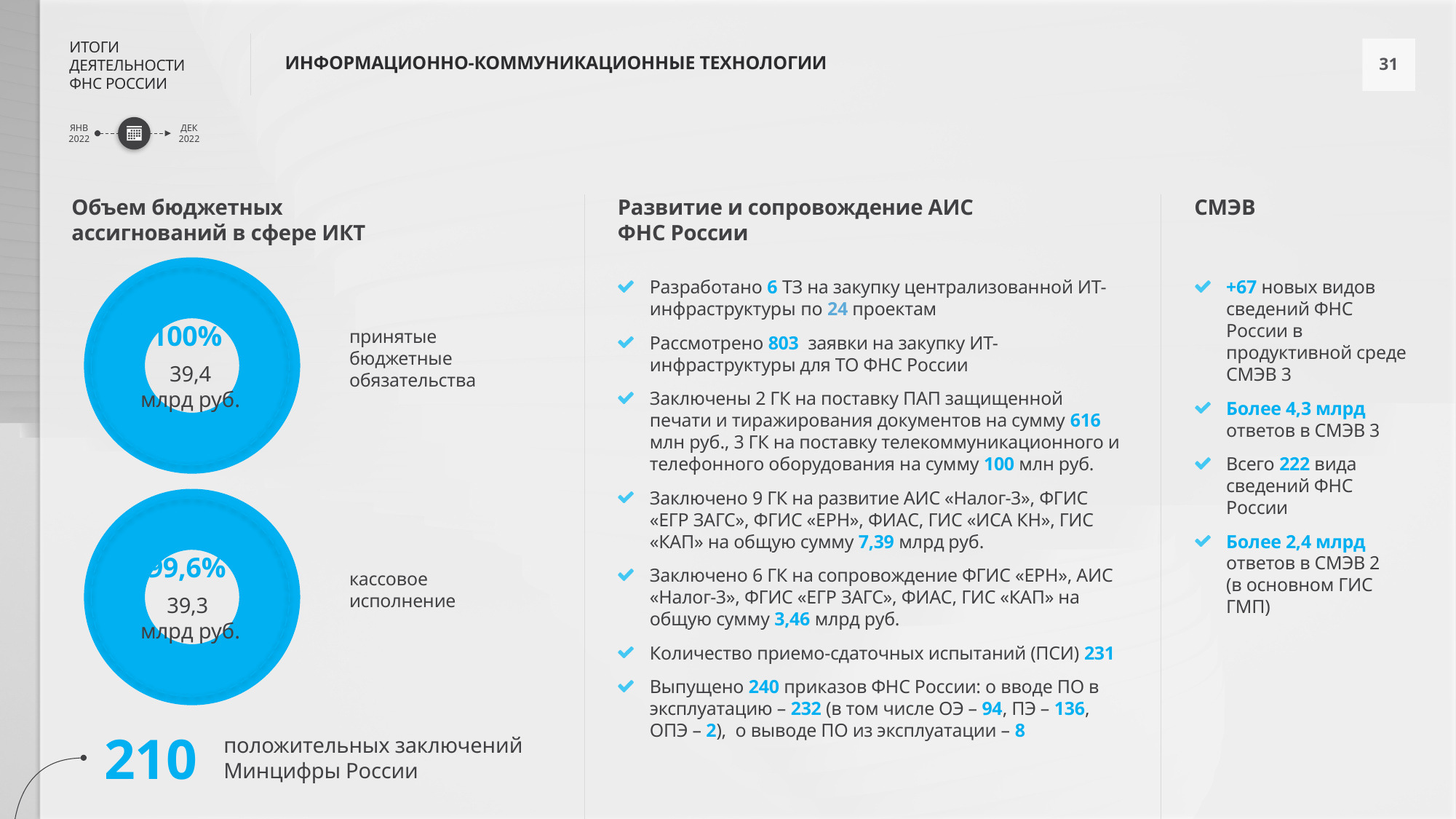
What kind of charts are shown on the left side of the slide under «Объем бюджетных ассигнований в сфере ИКТ»? donut charts What is the difference in percentage points between the top donut chart (100%) and the bottom donut chart (99,6%)? 0,4% In the top donut chart (принятые бюджетные обязательства), what amount is shown in the centre? 39,4 млрд руб. Which is larger: принятые бюджетные обязательства or кассовое исполнение? принятые бюджетные обязательства In the bottom donut chart (кассовое исполнение), what percentage is shown? 99,6% What share of the budget obligations does кассовое исполнение represent according to the bottom donut chart? 99,6% How many donut charts are shown on the slide? 2 In the top donut chart (принятые бюджетные обязательства), what percentage is shown? 100% What label is written next to the bottom donut chart? кассовое исполнение In the bottom donut chart (кассовое исполнение), what amount is shown in the centre? 39,3 млрд руб. What is the difference in млрд руб. between принятые бюджетные обязательства (39,4) and кассовое исполнение (39,3)? 0,1 млрд руб. What label is written next to the top donut chart? принятые бюджетные обязательства